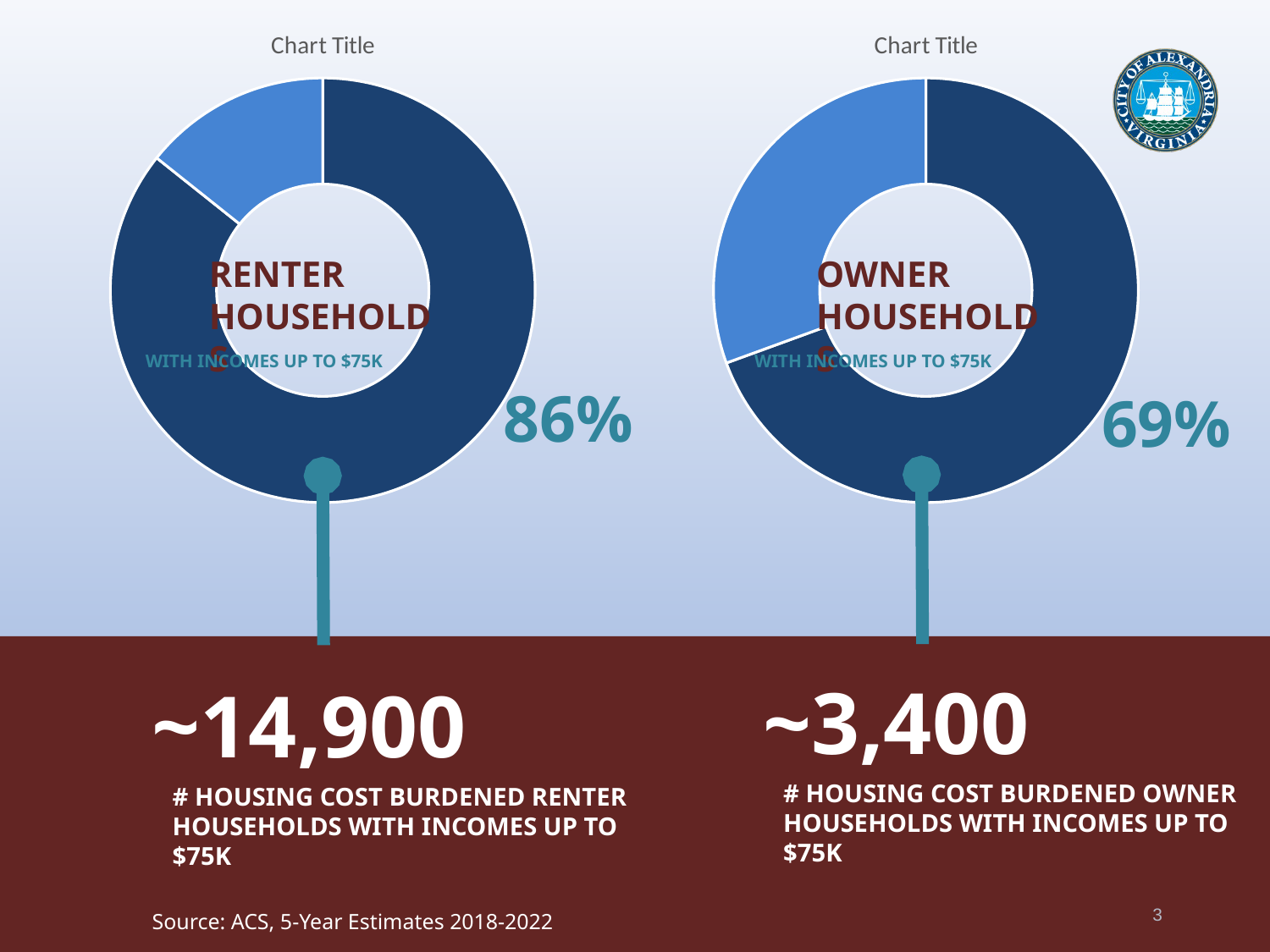
In the right chart (OWNER HOUSEHOLDS), how many slices does the donut have? 2 In the right chart (OWNER HOUSEHOLDS), is the light blue slice greater or less than 50% of the donut? less What is the difference in percentage points between the dark blue share in the left chart (86%) and the dark blue share in the right chart (69%)? 17 percentage points What kind of chart is shown on the right side of the slide, labelled OWNER HOUSEHOLDS? Donut (pie) chart What text is printed in the centre of the left donut chart? RENTER HOUSEHOLDS Which chart has the larger dark blue slice, the left (RENTER HOUSEHOLDS) chart or the right (OWNER HOUSEHOLDS) chart? The left (RENTER HOUSEHOLDS) chart What title is shown above each of the two donut charts? Chart Title What kind of chart is shown on the left side of the slide, labelled RENTER HOUSEHOLDS? Donut (pie) chart In the left chart (RENTER HOUSEHOLDS), how many slices does the donut have? 2 In the left chart (RENTER HOUSEHOLDS), what share of the donut is the large dark blue slice? 86% In the right chart (OWNER HOUSEHOLDS), what share of the donut is the large dark blue slice? 69% In the left chart (RENTER HOUSEHOLDS), what share of the donut is the small light blue slice? 14%